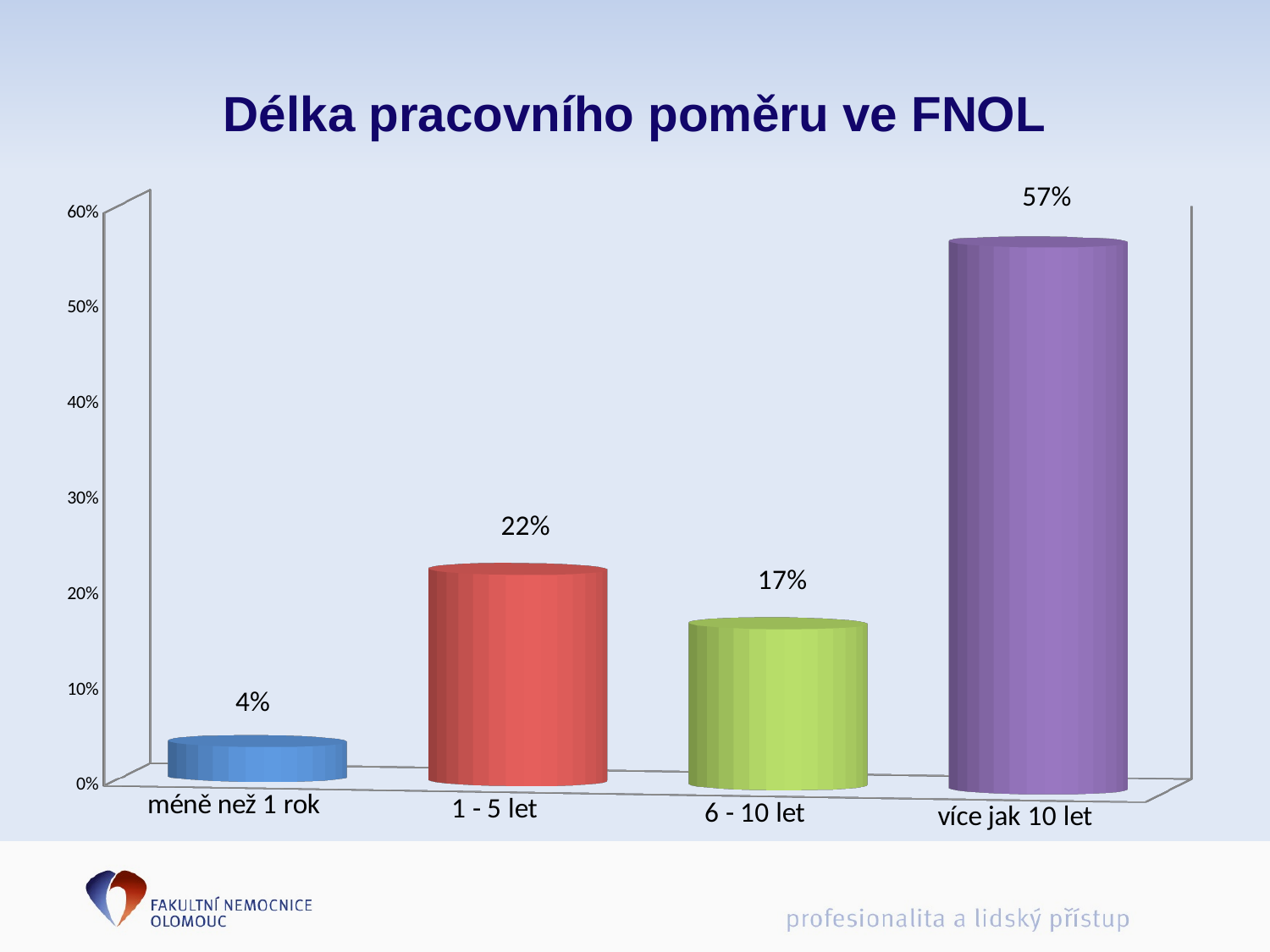
What is the value for "1 - 5 let"? 22% What is the difference between the values for "více jak 10 let" and "1 - 5 let"? 35% How many categories are shown on the chart? 4 What is the difference between the values for "1 - 5 let" and "6 - 10 let"? 5% What is the value for "méně než 1 rok"? 4% What is the value for "více jak 10 let"? 57% Which is larger, the value for "1 - 5 let" or the value for "6 - 10 let"? 1 - 5 let Which category has the highest value? více jak 10 let What kind of chart is shown on the slide? bar chart Is the value for "více jak 10 let" greater or less than 50%? greater Which category has the lowest value? méně než 1 rok What is the value for "6 - 10 let"? 17%